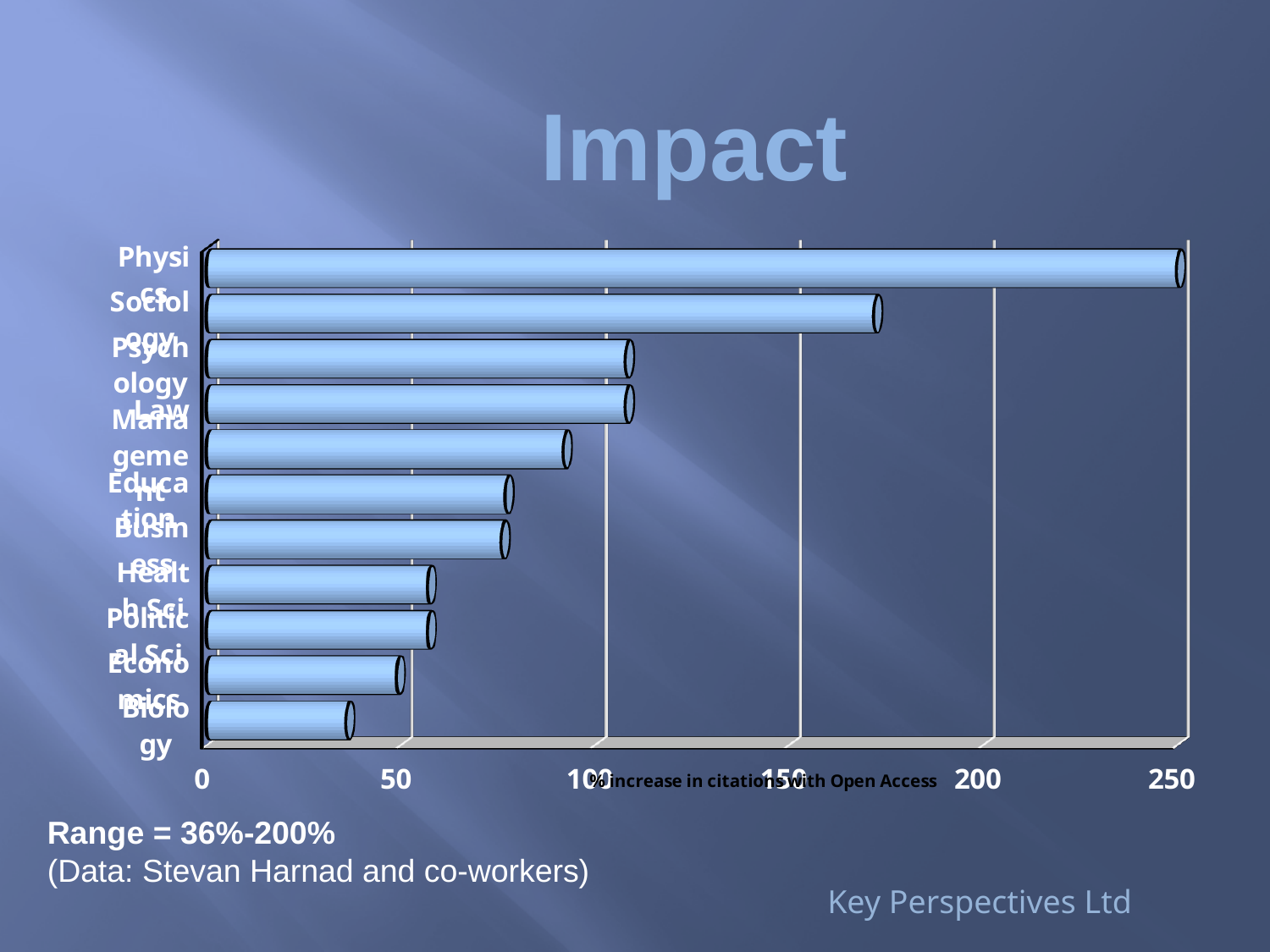
Is the value for Sociology greater or less than 150? greater What kind of chart is shown on the slide? bar chart Is the value for Biology greater or less than 50? less Is the value for Physics greater or less than 200? greater Which discipline has the lowest % increase in citations with Open Access? Biology Which has a larger value, Management or Health Sci? Management How many categories (disciplines) are plotted in the chart? 11 What is the label of the horizontal axis? % increase in citations with Open Access Which has a larger value, Sociology or Psychology? Sociology Which discipline has the highest % increase in citations with Open Access? Physics